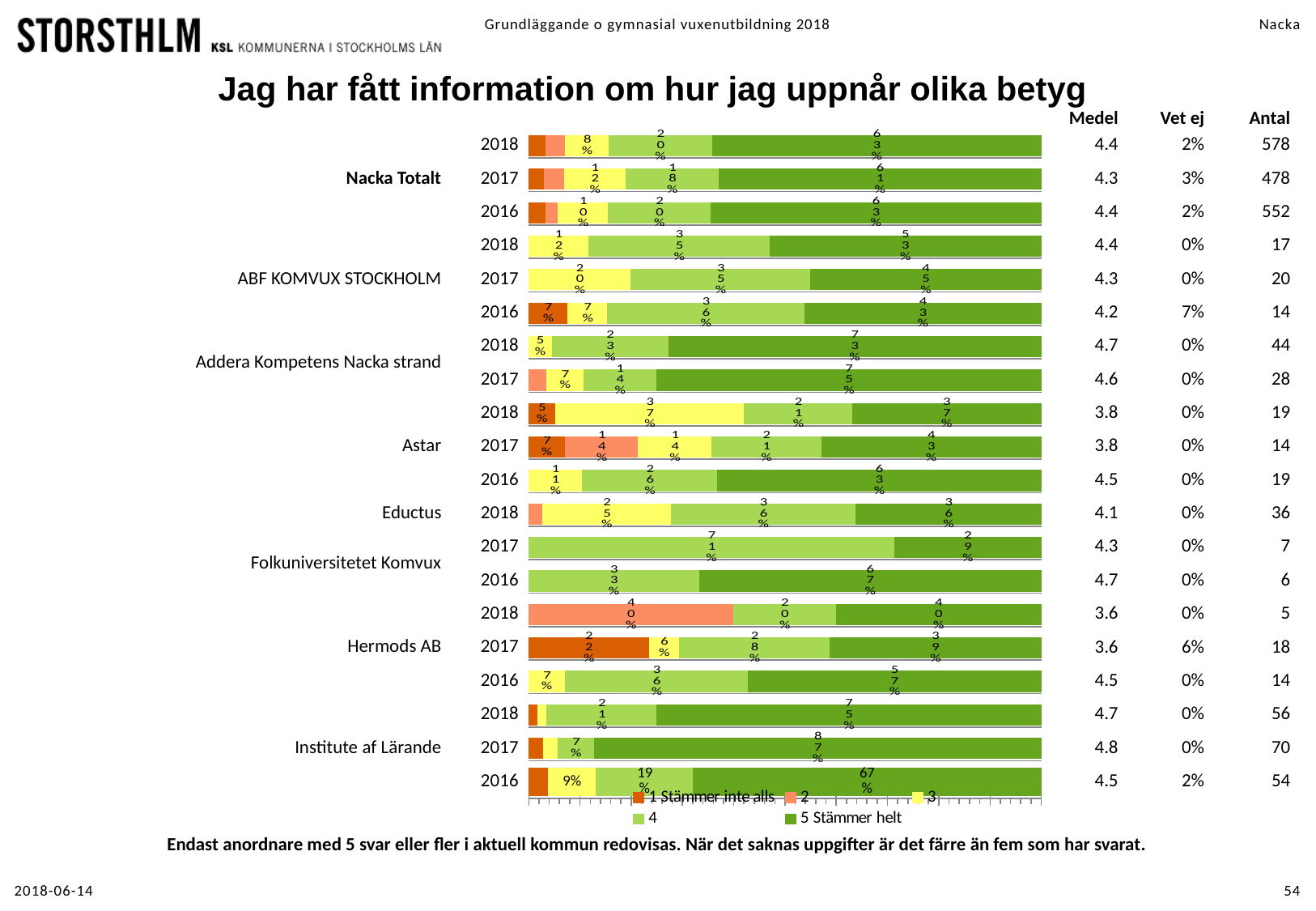
What is the '4' share for Institute af Lärande in 2016? 19% What is the '5 Stämmer helt' share for Institute af Lärande in 2017? 87% What is the label of the first legend entry (the dark orange series)? 1 Stämmer inte alls How many bars are plotted in the chart? 20 Which bar has the largest '5 Stämmer helt' share? Institute af Lärande 2017 What is the '4' share for Folkuniversitetet Komvux in 2017? 71% What kind of chart is shown on the slide? Stacked bar chart Which is larger: the '5 Stämmer helt' share for Institute af Lärande 2017 or for Nacka Totalt 2018? Institute af Lärande 2017 What is the difference between the '4' share and the '5 Stämmer helt' share for Folkuniversitetet Komvux in 2017? 42 percentage points How many series does the chart legend list? 5 What is the '5 Stämmer helt' share for Institute af Lärande in 2016? 67% What is the '5 Stämmer helt' share for Folkuniversitetet Komvux in 2016? 67%